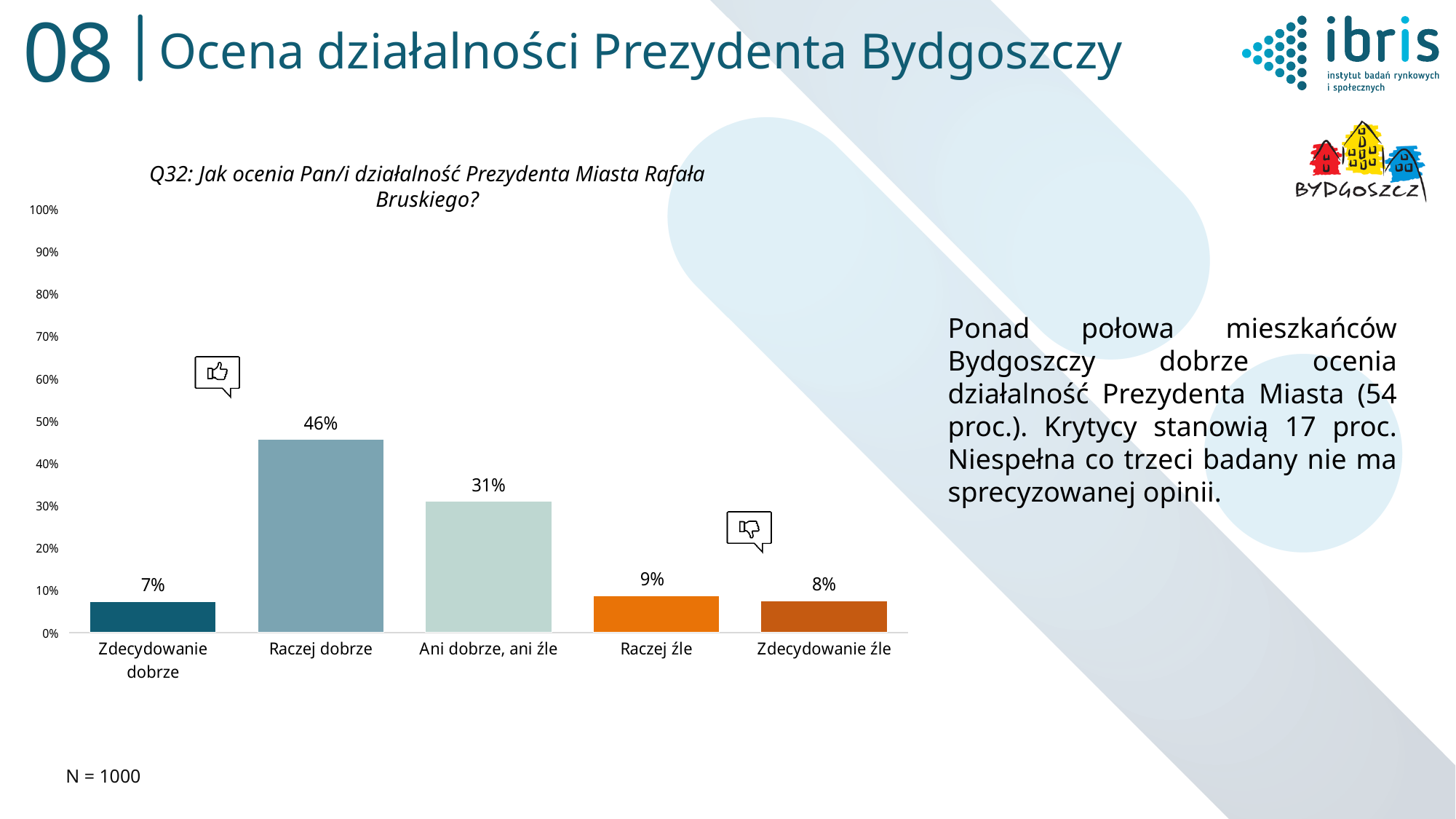
What is the value for "Zdecydowanie dobrze"? 7% Which category has the lowest value? Zdecydowanie dobrze Which is larger, the value for "Raczej źle" or the value for "Zdecydowanie źle"? Raczej źle Is the value for "Ani dobrze, ani źle" greater or less than 40%? less Which category has the highest value? Raczej dobrze What is the difference between the values for "Raczej dobrze" and "Ani dobrze, ani źle"? 15% What is the value for "Ani dobrze, ani źle"? 31% What kind of chart is shown on the slide? bar chart How many categories are shown on the x axis? 5 What is the value for "Raczej dobrze"? 46% What is the sample size (N) stated on the slide? N = 1000 What is the value for "Zdecydowanie źle"? 8%